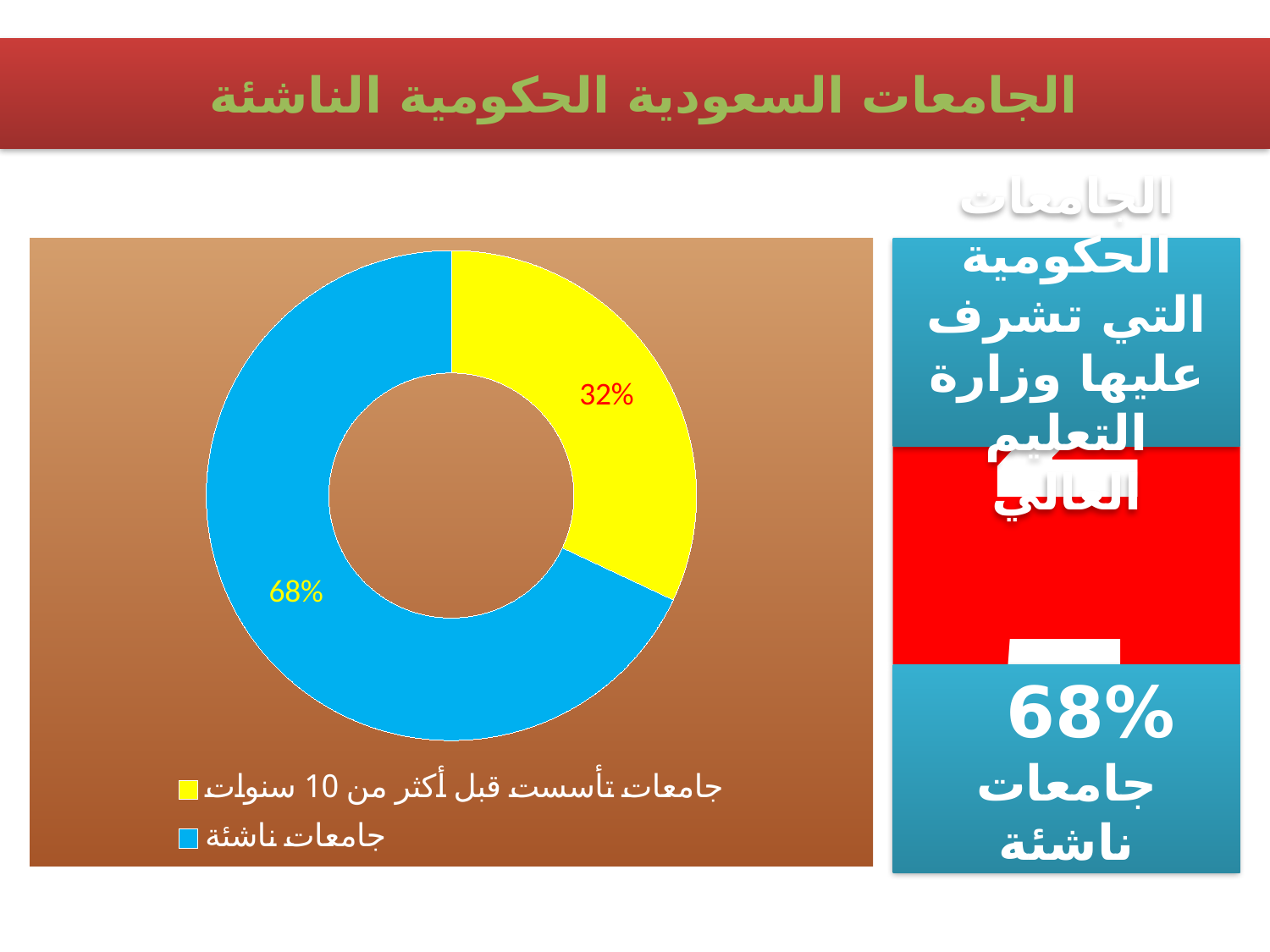
What percentage is shown for جامعات ناشئة? 68% What is the difference in percentage points between جامعات ناشئة and جامعات تأسست قبل أكثر من 10 سنوات? 36 Which is larger: the share for جامعات ناشئة or the share for جامعات تأسست قبل أكثر من 10 سنوات? جامعات ناشئة Which category has the largest share of the doughnut chart? جامعات ناشئة What colour is the slice for جامعات تأسست قبل أكثر من 10 سنوات? Yellow What kind of chart is shown on the slide? Doughnut chart What percentage is shown for جامعات تأسست قبل أكثر من 10 سنوات? 32% Which category has the smallest share of the doughnut chart? جامعات تأسست قبل أكثر من 10 سنوات How many categories are shown in the doughnut chart? 2 What is the total of the two percentages shown in the doughnut chart? 100% How many entries does the legend list? 2 What colour is the slice for جامعات ناشئة? Blue